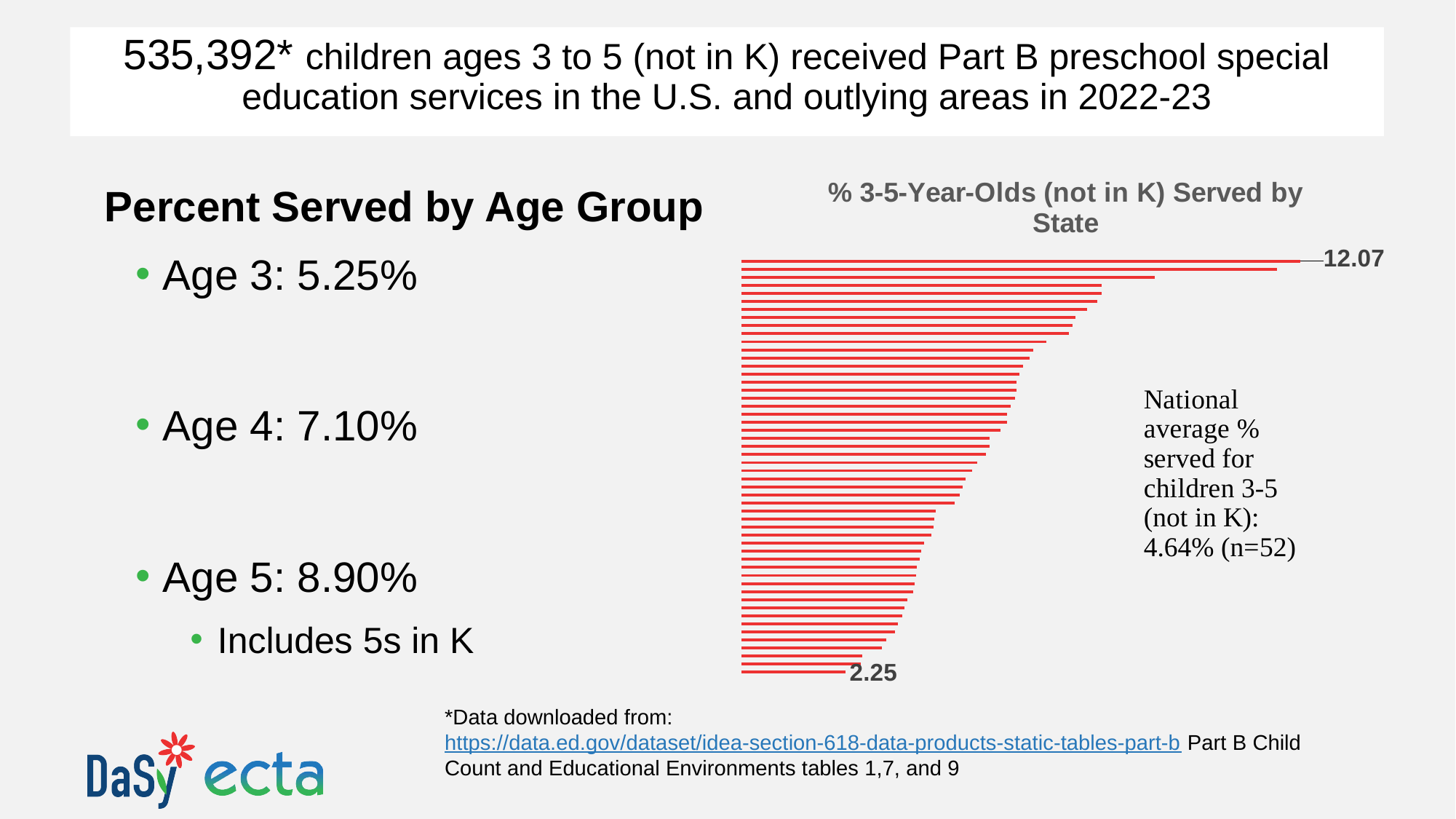
Is the lowest value in the chart greater or less than 5? less Which is larger, the value labeled at the top of the chart or the value labeled at the bottom? the top value (12.07) What is the title of the chart on the right side of the slide? % 3-5-Year-Olds (not in K) Served by State What is the highest value shown in the chart? 12.07 What kind of chart is shown on the slide? bar chart What colour are the bars in the chart? red Is the highest value in the chart greater or less than 10? greater What is the difference between the highest and lowest values labeled in the chart? 9.82 What is the lowest value shown in the chart? 2.25 According to the annotation next to the chart, what is the national average percent served for children 3-5 (not in K)? 4.64% Do the bar values increase or decrease from the top of the chart to the bottom? decrease